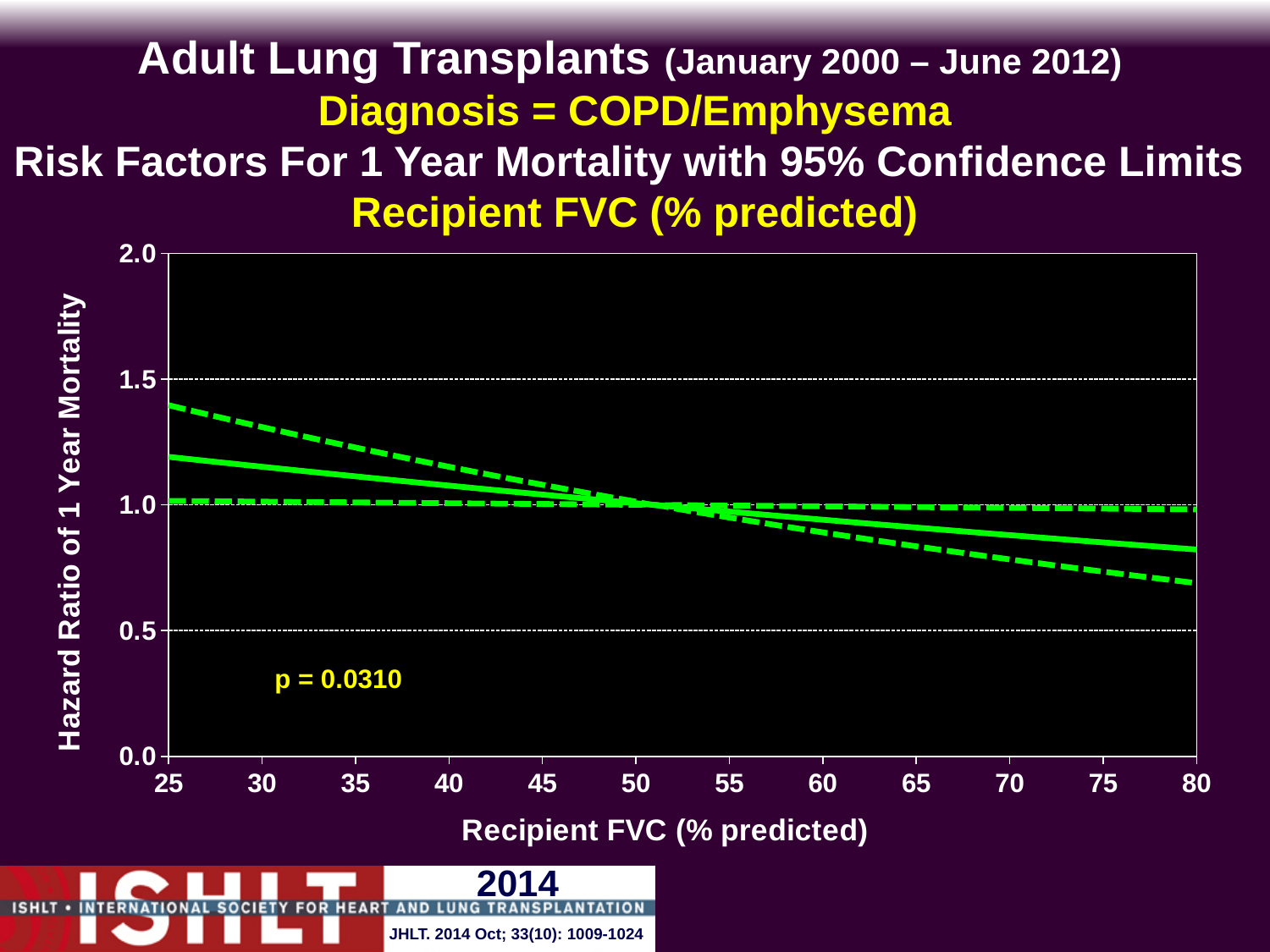
Is the hazard ratio (solid line) at a Recipient FVC of 80% predicted greater or less than 1.0? less What kind of chart is shown on the slide? line chart Does the solid hazard ratio line rise or fall as Recipient FVC (% predicted) increases from 25 to 80? fall Is the lower 95% confidence limit (lower dashed line) at a Recipient FVC of 80% predicted greater or less than 0.5? greater What is the p-value printed on the chart? p = 0.0310 Is the hazard ratio (solid line) at a Recipient FVC of 25% predicted greater or less than 1.0? greater Which has the larger hazard ratio on the solid line: a Recipient FVC of 25% predicted or 80% predicted? 25% predicted What is the label of the y axis? Hazard Ratio of 1 Year Mortality How many tick labels are shown on the x axis? 12 How many lines are plotted on the chart? 3